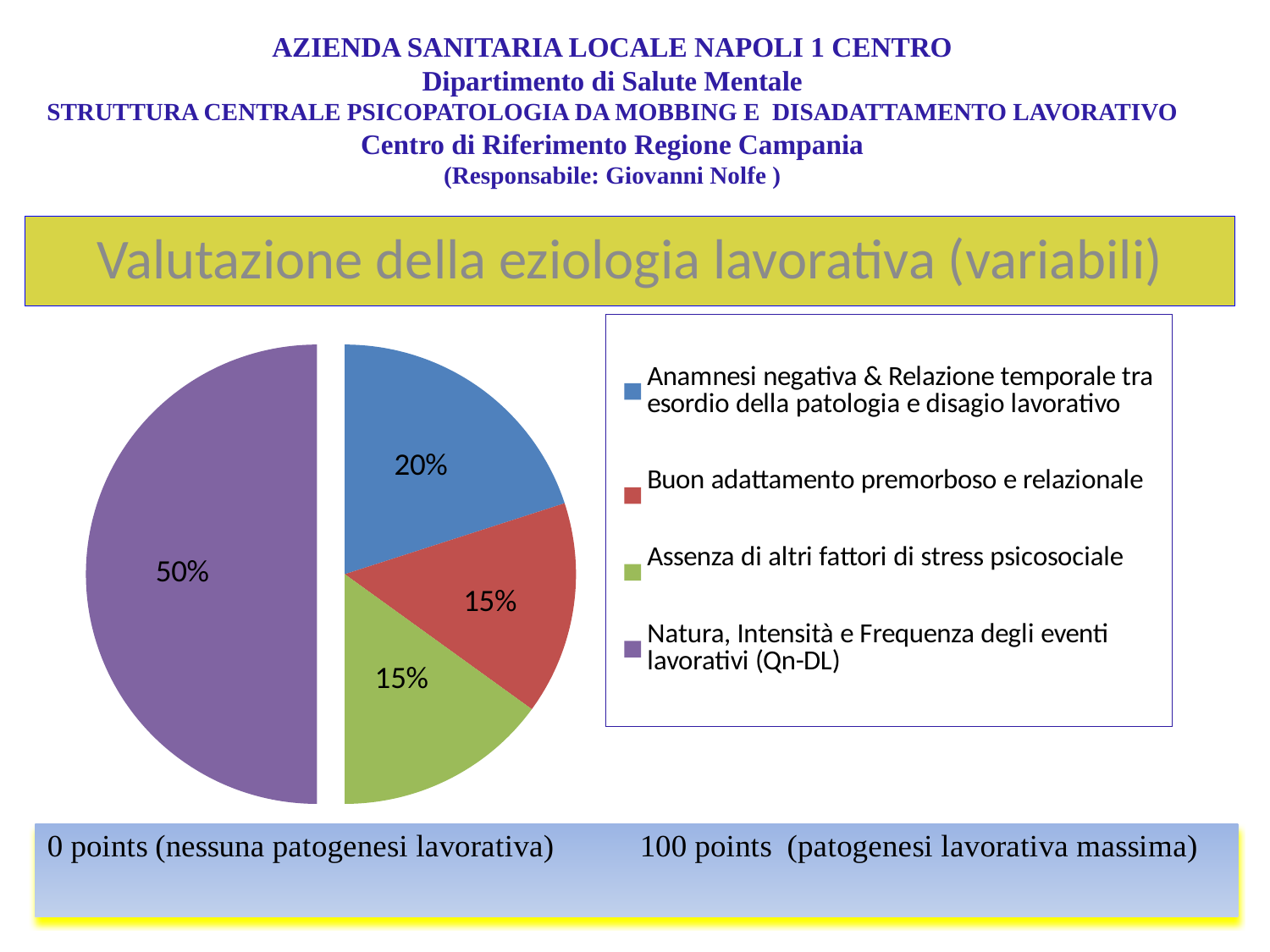
What kind of chart is shown on the slide? Pie chart What share of the pie does "Natura, Intensità e Frequenza degli eventi lavorativi (Qn-DL)" have? 50% Which category has the largest slice of the pie? Natura, Intensità e Frequenza degli eventi lavorativi (Qn-DL) How many entries does the legend list? 4 What is the title shown above the pie chart? Valutazione della eziologia lavorativa (variabili) What colour is the slice for "Natura, Intensità e Frequenza degli eventi lavorativi (Qn-DL)"? Purple What share of the pie does "Buon adattamento premorboso e relazionale" have? 15% What share of the pie does "Anamnesi negativa & Relazione temporale tra esordio della patologia e disagio lavorativo" have? 20% How many slices does the pie chart have? 4 What is the difference between the share for "Natura, Intensità e Frequenza degli eventi lavorativi (Qn-DL)" and the share for "Anamnesi negativa & Relazione temporale tra esordio della patologia e disagio lavorativo"? 30% Which is larger: the share for "Anamnesi negativa & Relazione temporale tra esordio della patologia e disagio lavorativo" or the share for "Buon adattamento premorboso e relazionale"? Anamnesi negativa & Relazione temporale tra esordio della patologia e disagio lavorativo What share of the pie does "Assenza di altri fattori di stress psicosociale" have? 15%